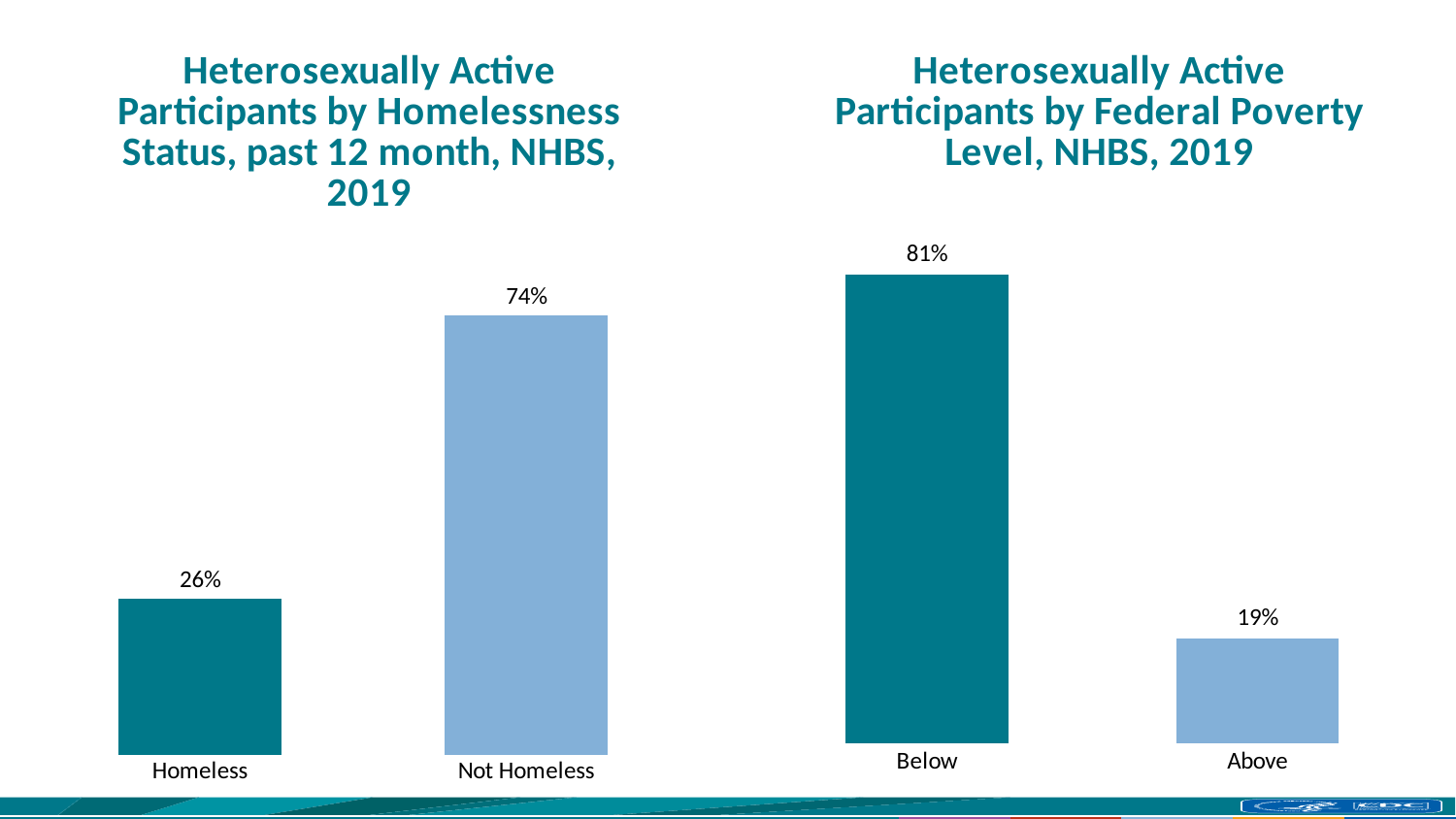
In the Federal Poverty Level chart on the right, what is the difference between the Below and Above percentages? 62% What type of chart is the Homelessness Status chart on the left? bar chart In the Federal Poverty Level chart on the right, what percentage of participants were Below the federal poverty level? 81% What is the title of the chart on the right? Heterosexually Active Participants by Federal Poverty Level, NHBS, 2019 In the Homelessness Status chart on the left, which category has the higher value? Not Homeless Is the Homeless value in the left chart larger or smaller than the Above value in the right chart? larger In the Federal Poverty Level chart on the right, which category has the lowest value? Above In the Federal Poverty Level chart on the right, what percentage of participants were Above the federal poverty level? 19% In the Homelessness Status chart on the left, what percentage of participants were Homeless? 26% How many categories are shown in the Federal Poverty Level chart on the right? 2 In the Homelessness Status chart on the left, what percentage of participants were Not Homeless? 74% In the Homelessness Status chart on the left, what is the difference between the Not Homeless and Homeless percentages? 48%